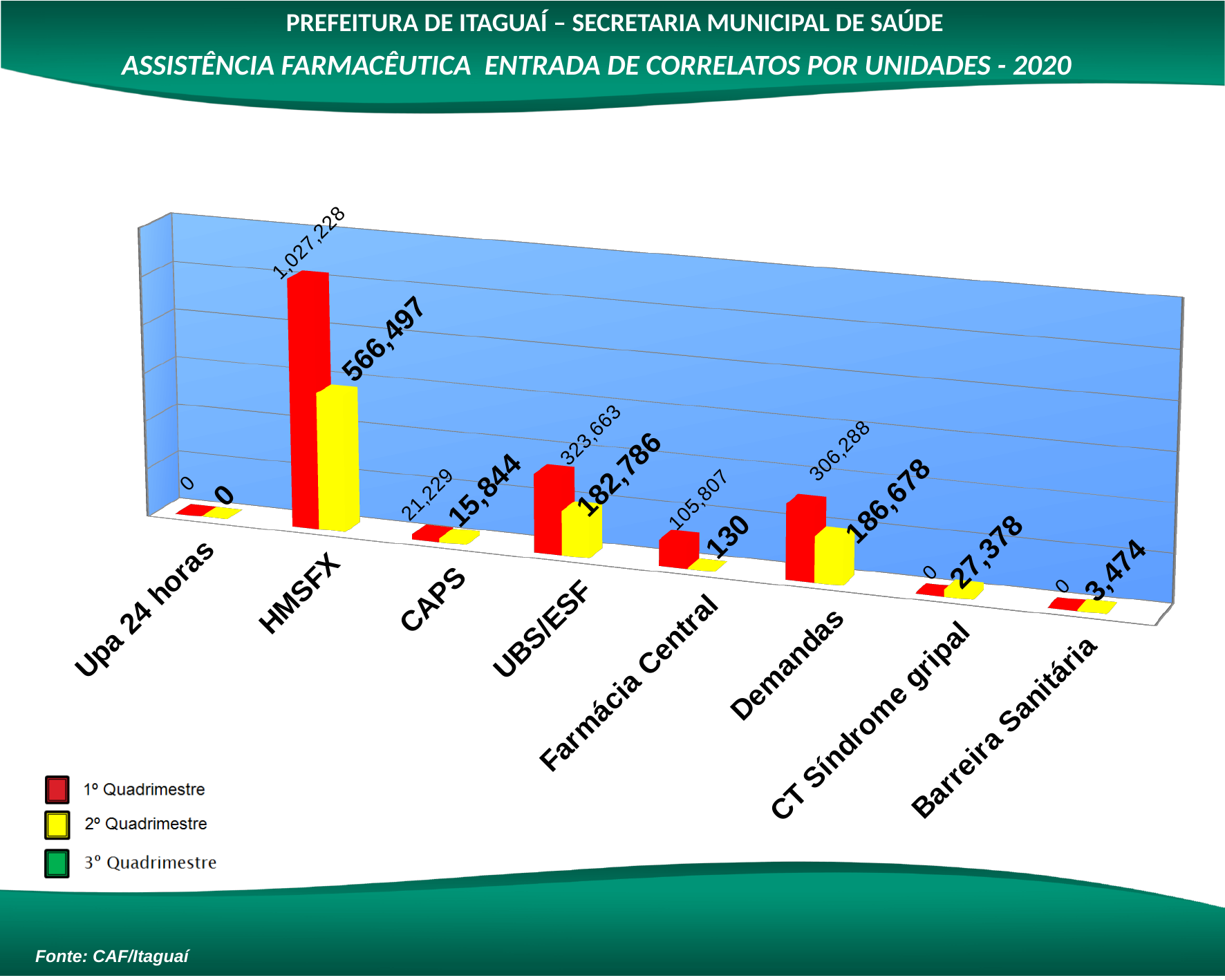
Which category has the highest 1º Quadrimestre value? HMSFX What is the 2º Quadrimestre value for Farmácia Central? 130 How many categories are shown on the x axis? 8 What is the 2º Quadrimestre value for CT Síndrome gripal? 27,378 What is the 1º Quadrimestre value for Demandas? 306,288 Which category has the lowest 2º Quadrimestre value? Upa 24 horas How many series does the legend list? 3 What kind of chart is shown on the slide? Bar chart What is the difference between the 1º Quadrimestre and 2º Quadrimestre values for HMSFX? 460,731 What is the 1º Quadrimestre value for HMSFX? 1,027,228 Which is larger for Demandas: the 1º Quadrimestre value or the 2º Quadrimestre value? 1º Quadrimestre What is the 2º Quadrimestre value for UBS/ESF? 182,786